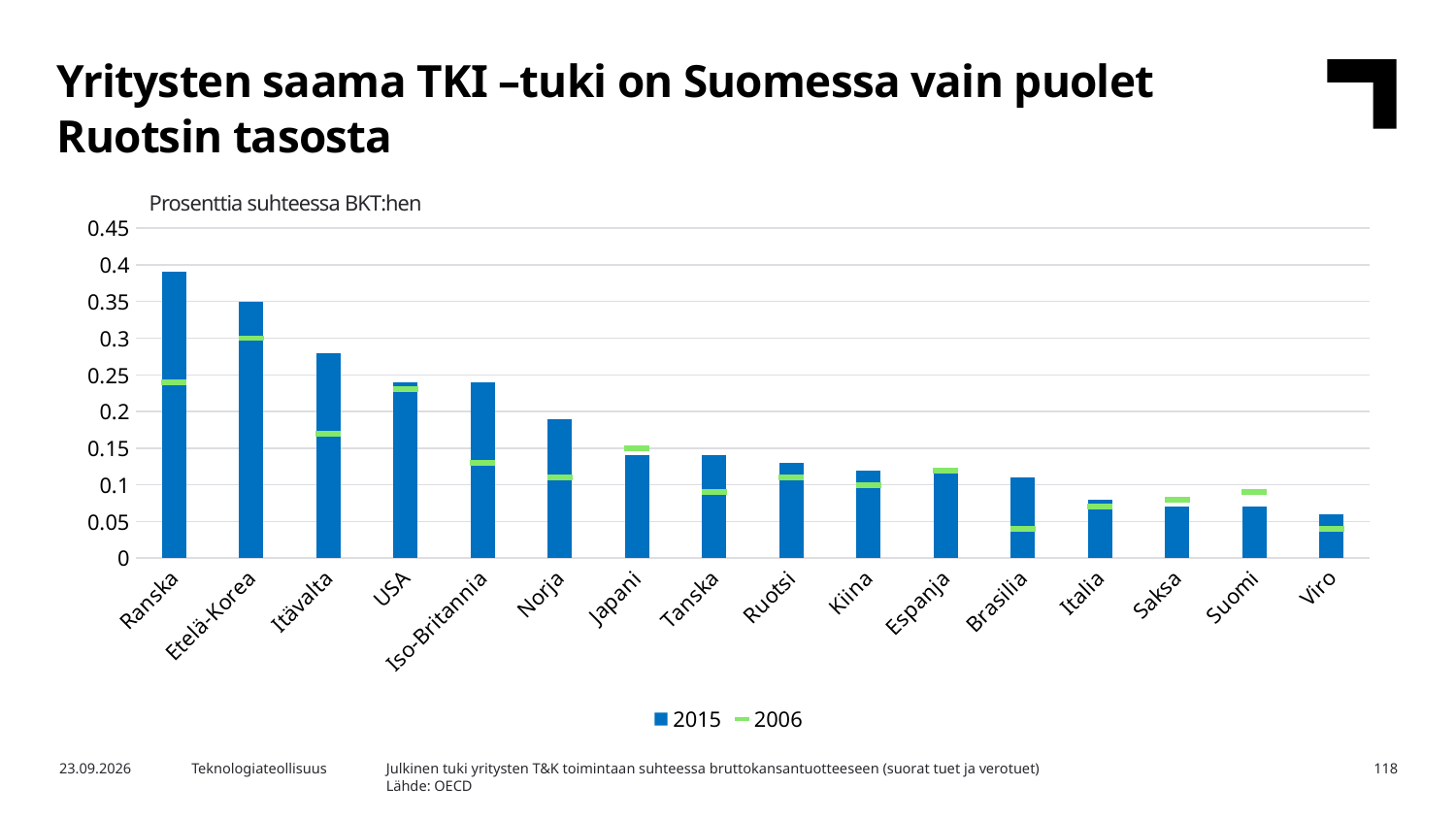
Which country has the lowest 2015 value in the chart? Viro How many countries are shown on the x axis of the chart? 16 Is the 2015 value for Suomi greater or less than 0.1? less Which country has the highest 2015 value in the chart? Ranska Which has the larger 2015 value, Suomi or Ruotsi? Ruotsi Is the 2015 value for Norja greater or less than 0.2? less Is the 2015 value for Ranska greater or less than 0.35? greater Which has the larger 2015 value, Ranska or Etelä-Korea? Ranska What are the two series named in the chart legend? 2015 and 2006 Do the 2015 values generally rise or fall from left to right along the x axis? fall How many series does the chart legend list? 2 What kind of chart is shown on the slide? bar chart